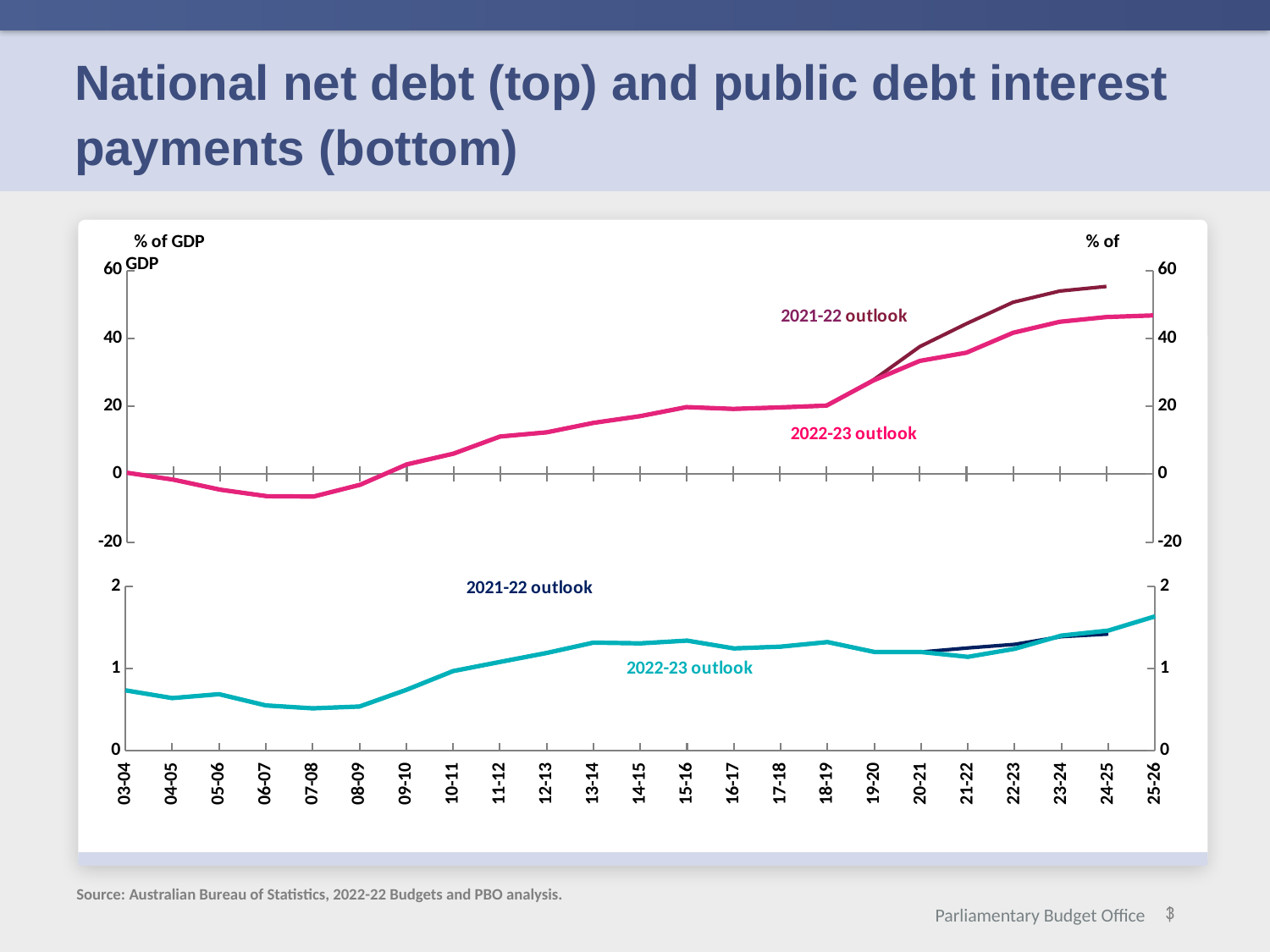
In the bottom chart (public debt interest payments), is the value for 03-04 greater or less than 1? less What kind of chart is the top chart (national net debt)? line chart How many series are labelled in the top chart (national net debt)? 2 What unit is shown on the y axis label of the top chart? % of GDP In the top chart (national net debt), does the 2022-23 outlook line rise or fall from 18-19 to 25-26? rise In the top chart (national net debt), is the value for 13-14 greater or less than 20? less In the top chart (national net debt), is the value for 07-08 greater or less than 0? less How many financial years are shown along the x axis of the bottom chart? 23 In the bottom chart (public debt interest payments), does the 2022-23 outlook line rise or fall from 03-04 to 07-08? fall In the top chart (national net debt), which series is higher at 24-25, the 2021-22 outlook or the 2022-23 outlook? 2021-22 outlook